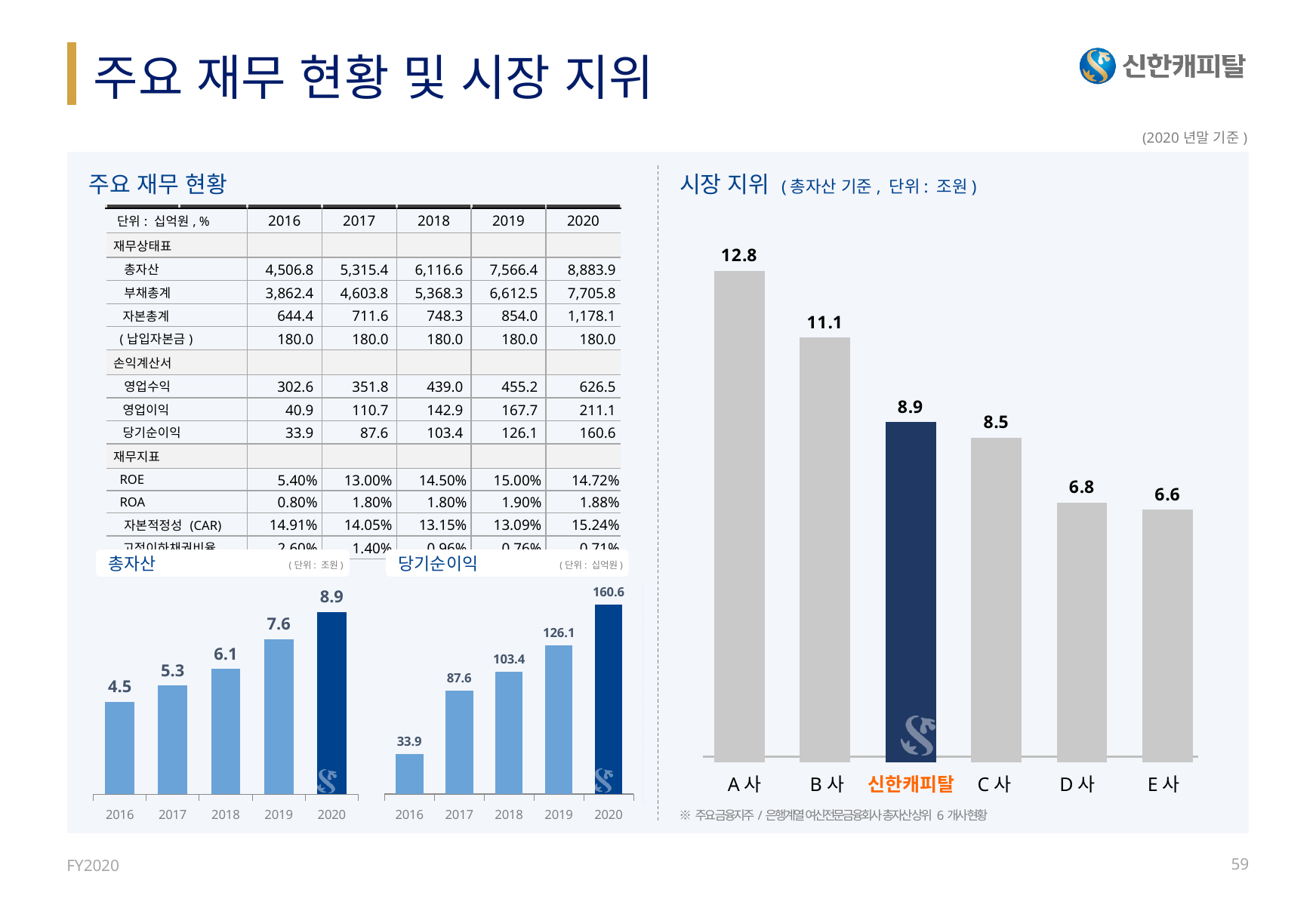
In the 당기순이익 chart, what is the difference between 2020 and 2019? 34.5 In the 당기순이익 chart, what is the value for 2016? 33.9 In the 시장 지위 chart, what is the value for 신한캐피탈? 8.9 In the 시장 지위 chart, what unit is stated in the chart title? 조원 In the 시장 지위 chart, which is larger, the value for C 사 or D 사? C 사 In the 총자산 chart, what is the value for 2020? 8.9 In the 총자산 chart, do the values rise or fall from 2016 to 2020? rise In the 시장 지위 chart, which company has the lowest value? E 사 In the 시장 지위 chart, how many companies are shown? 6 In the 시장 지위 chart, which company has the highest value? A 사 What kind of chart is the 당기순이익 chart? bar chart In the 시장 지위 chart, what is the difference between A 사 and B 사? 1.7